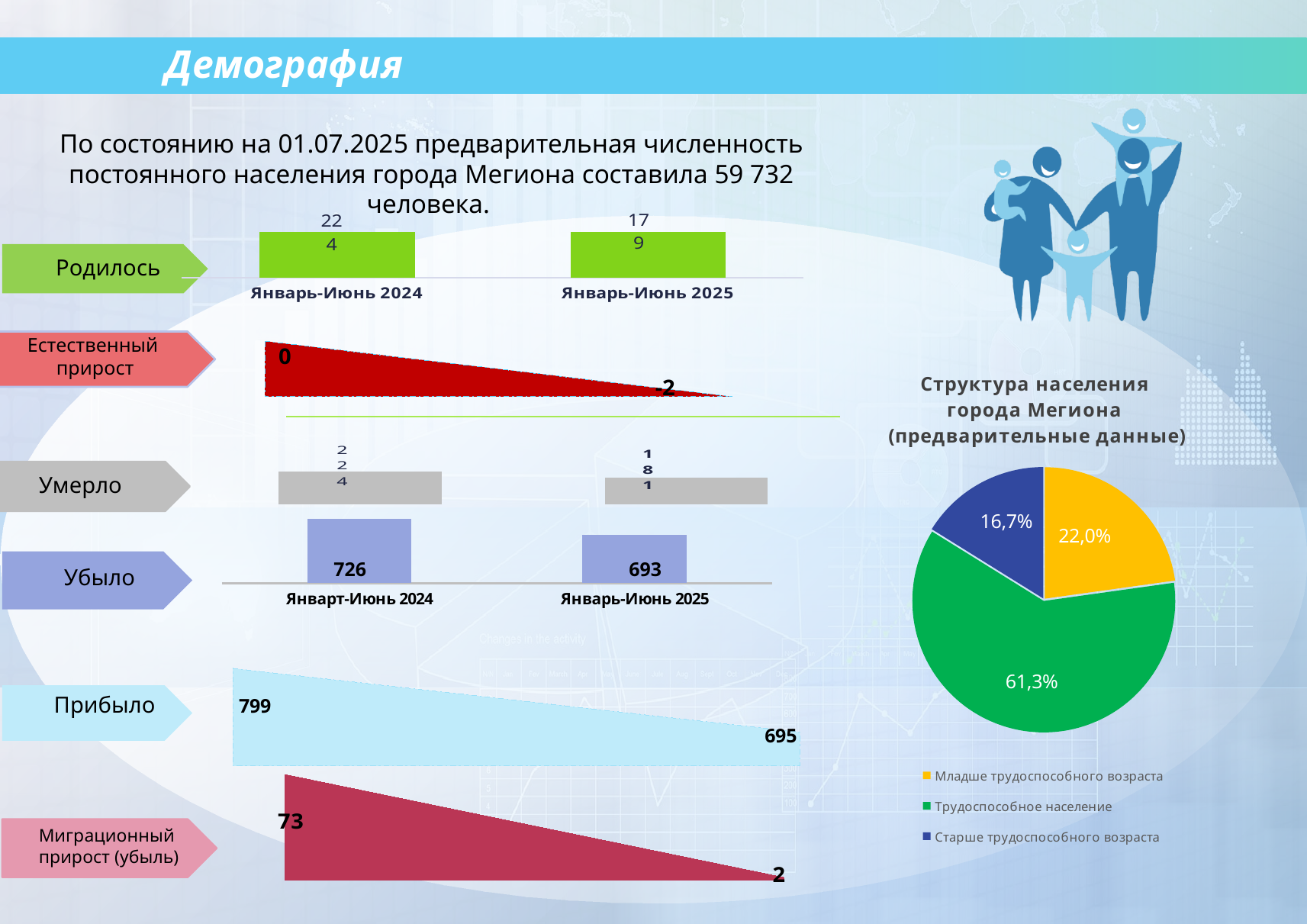
In the 'Миграционный прирост (убыль)' chart, what are the two values shown? 73 and 2 In the 'Убыло' chart, what is the difference between the 2024 and 2025 values? 33 In the 'Прибыло' chart, what is the first (left) value shown? 799 In the 'Прибыло' chart, what is the second (right) value shown? 695 In the pie chart 'Структура населения города Мегиона', what share is 'Трудоспособное население'? 61,3% How many entries does the legend of the pie chart 'Структура населения города Мегиона' list? 3 In the pie chart 'Структура населения города Мегиона', which category has the largest share? Трудоспособное население In the 'Убыло' chart, what is the value for Январь-Июнь 2025? 693 In the 'Естественный прирост' chart, what is the second (right) value shown? -2 In the 'Убыло' chart, what is the value for Январт-Июнь 2024? 726 In the 'Прибыло' chart, do the values rise or fall from left to right? fall In the pie chart 'Структура населения города Мегиона', what share is 'Старше трудоспособного возраста'? 16,7%